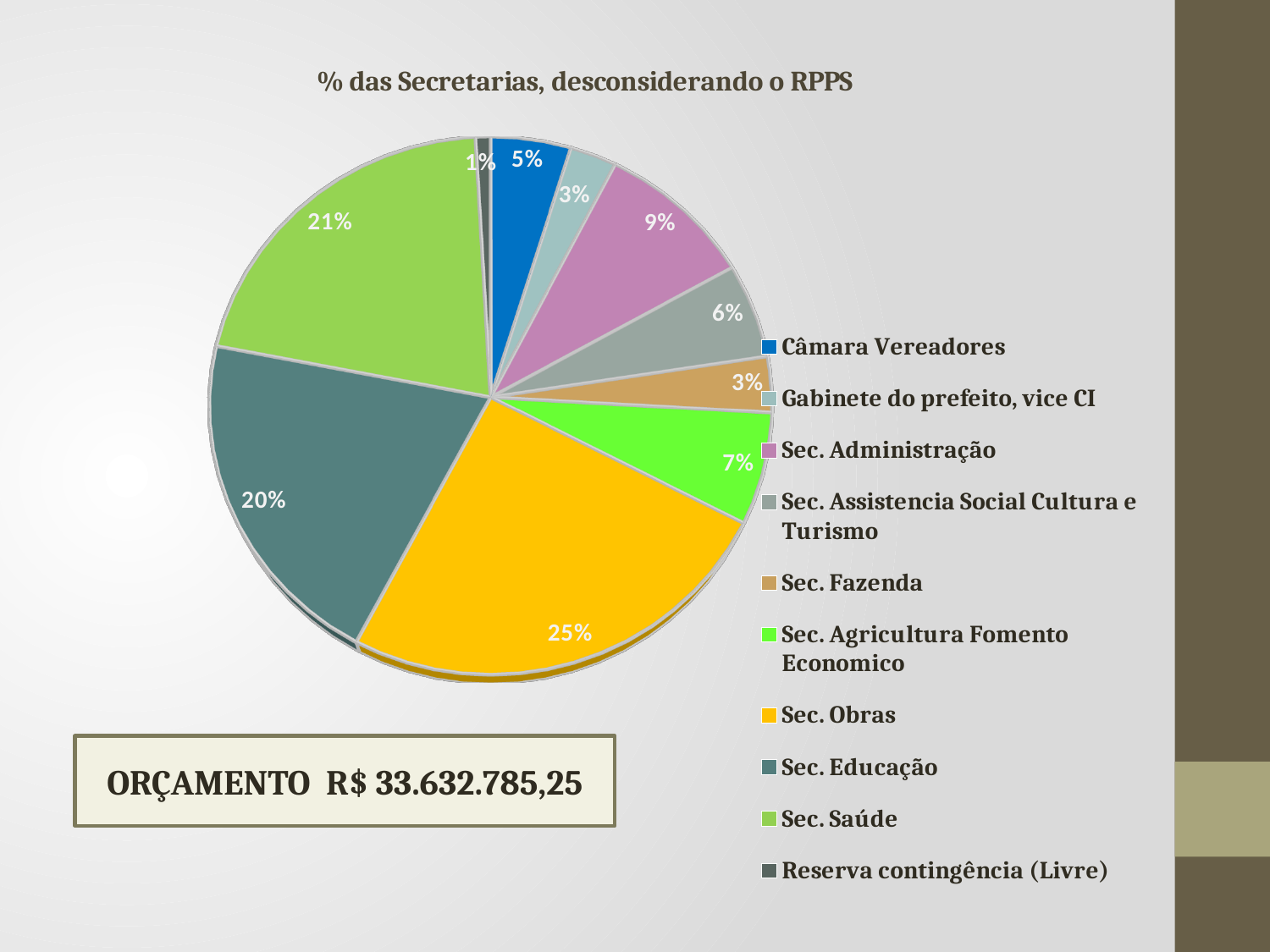
What is the title of the chart? % das Secretarias, desconsiderando o RPPS What share of the pie does Sec. Educação have? 20% What share of the pie does Sec. Obras have? 25% How many entries does the chart legend list? 10 What share of the pie does Sec. Administração have? 9% Which category has the smallest slice of the pie? Reserva contingência (Livre) Which is larger, the slice for Sec. Agricultura Fomento Economico or the slice for Sec. Assistencia Social Cultura e Turismo? Sec. Agricultura Fomento Economico What is the difference in percentage points between Sec. Obras and Sec. Educação? 5 Which category has the largest slice of the pie? Sec. Obras What kind of chart is shown on the slide? pie chart